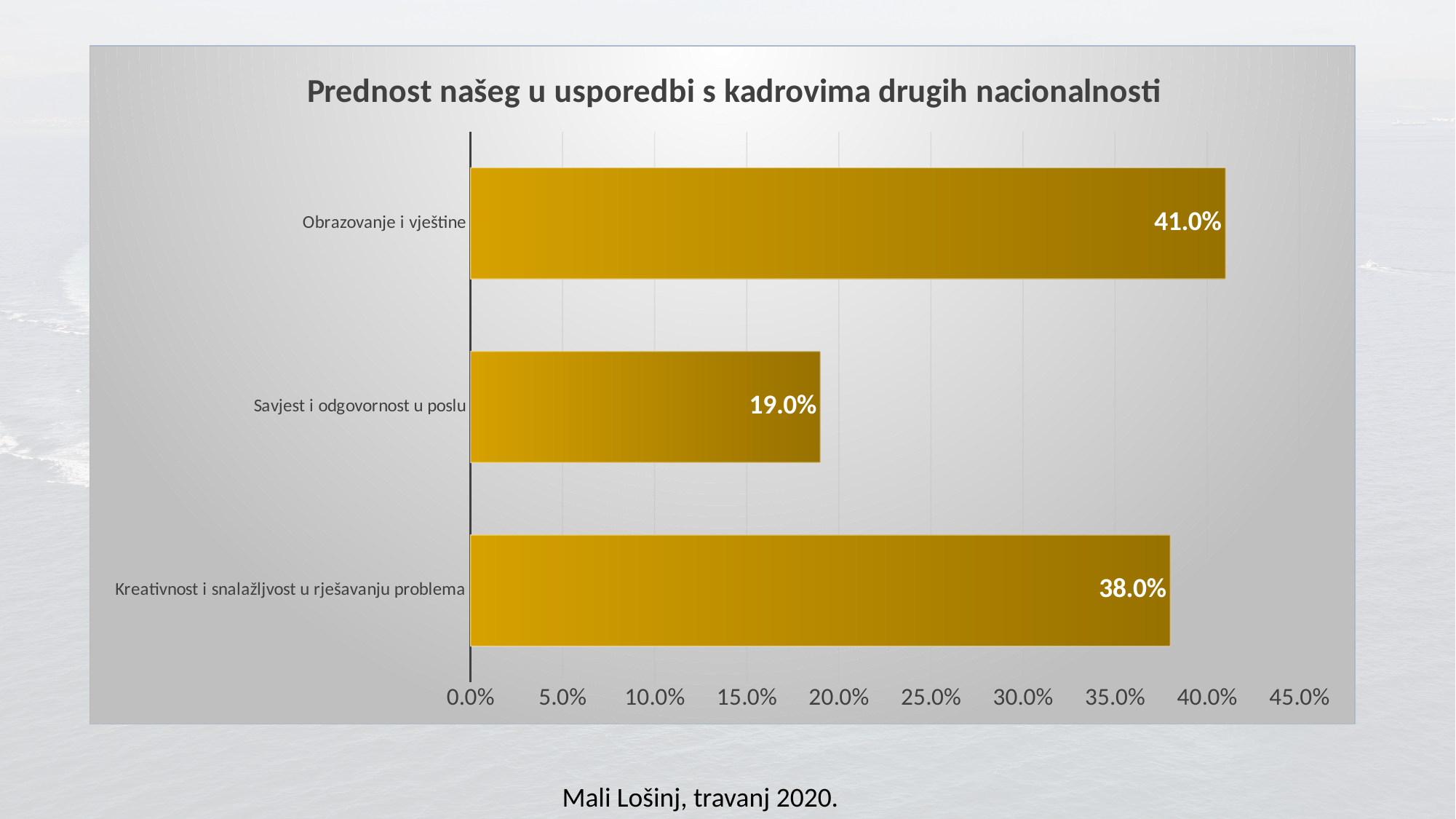
Which category has the highest value? Obrazovanje i vještine What is the difference between the values for Kreativnost i snalažljivost u rješavanju problema and Savjest i odgovornost u poslu? 19.0% What is the title of the chart? Prednost našeg u usporedbi s kadrovima drugih nacionalnosti What is the value for Kreativnost i snalažljivost u rješavanju problema? 38.0% What is the value for Obrazovanje i vještine? 41.0% What is the difference between the values for Obrazovanje i vještine and Kreativnost i snalažljivost u rješavanju problema? 3.0% What kind of chart is shown on the slide? bar chart Is the value for Savjest i odgovornost u poslu greater or less than 20.0%? less Which category has the lowest value? Savjest i odgovornost u poslu Which is larger, the value for Savjest i odgovornost u poslu or the value for Kreativnost i snalažljivost u rješavanju problema? Kreativnost i snalažljivost u rješavanju problema How many categories are shown in the chart? 3 What is the value for Savjest i odgovornost u poslu? 19.0%